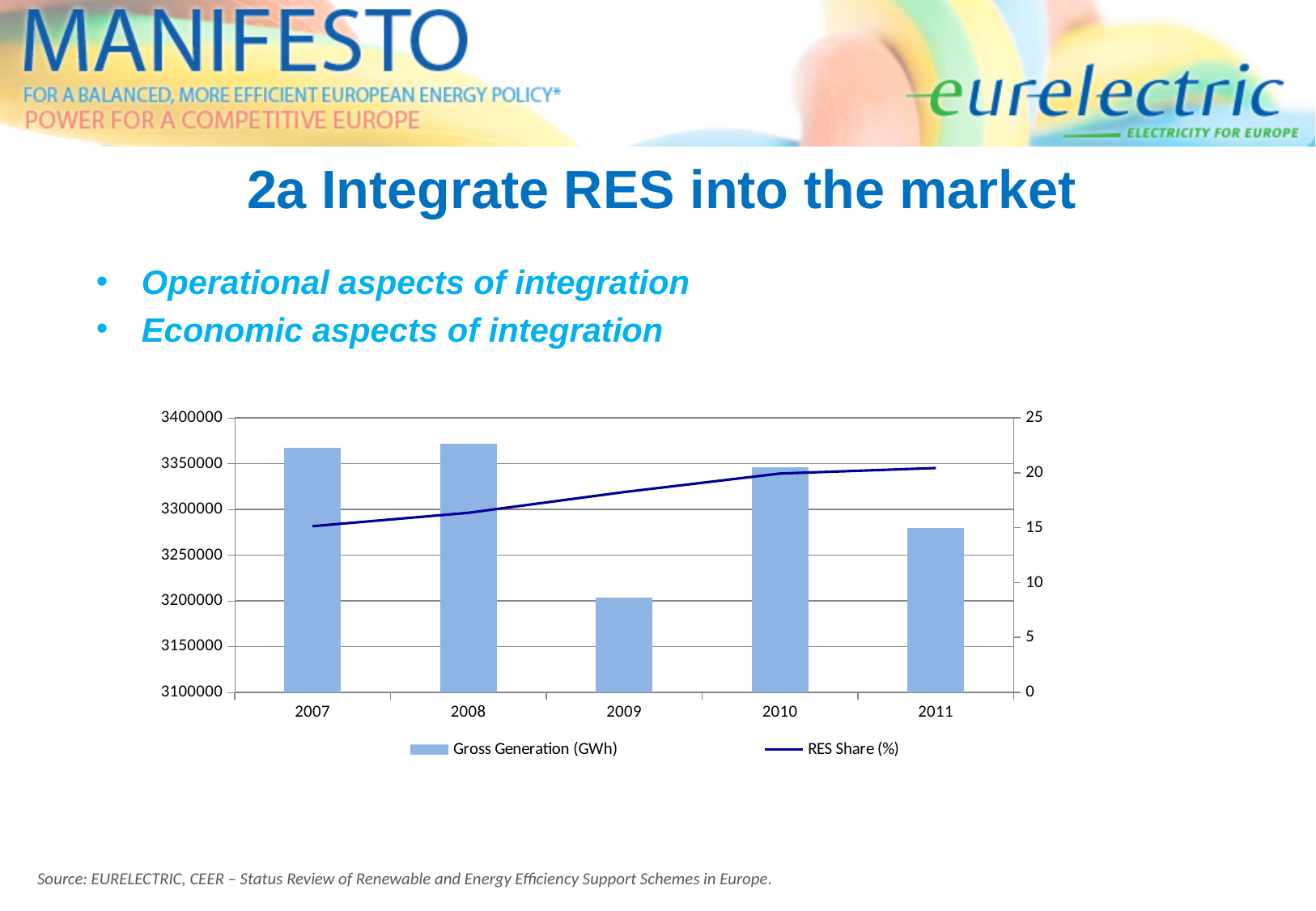
Does the RES Share (%) rise or fall from 2007 to 2011? Rise Is the RES Share (%) for 2007 greater or less than 20? less Is the Gross Generation (GWh) for 2010 greater or less than 3300000? greater Is the RES Share (%) for 2011 greater or less than 15? greater Which year has the larger Gross Generation (GWh), 2009 or 2010? 2010 What are the two series named in the chart's legend? Gross Generation (GWh) and RES Share (%) Which year has the lowest Gross Generation (GWh)? 2009 How many years are shown on the x axis of the chart? 5 How many series does the chart's legend list? 2 What kind of chart is shown on the slide? Combination bar and line chart